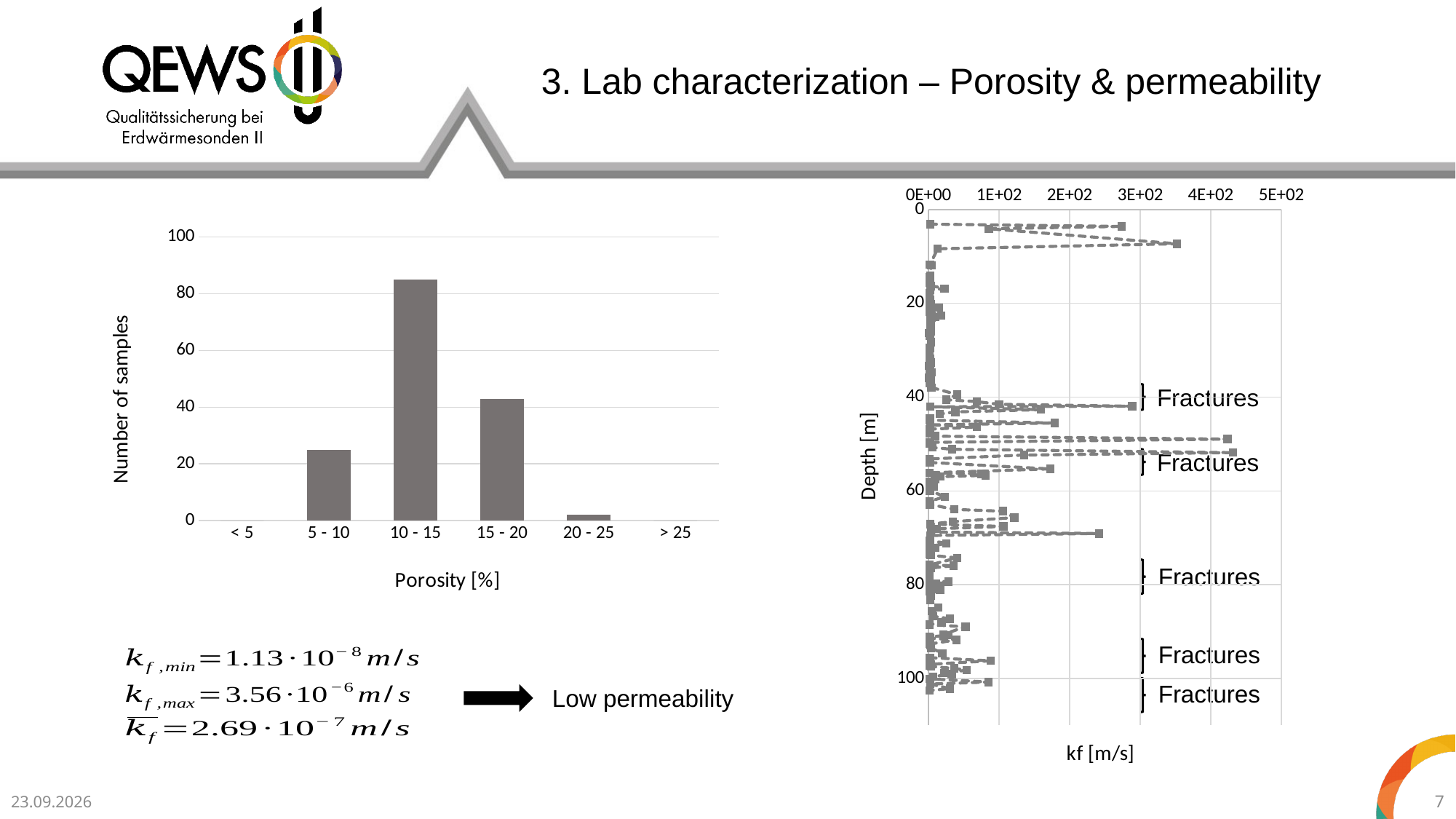
In the left bar chart, what is the label of the y axis? Number of samples In the right chart, what is the highest value shown on the horizontal kf [m/s] axis? 5E+02 In the left bar chart, is the number of samples for the 10 - 15 porosity category greater or less than 80? greater In the left bar chart, which porosity category has the highest number of samples? 10 - 15 In the left bar chart, how many porosity categories are shown on the x axis? 6 In the left bar chart, is the number of samples for the 15 - 20 porosity category greater or less than 60? less In the left bar chart, which has more samples, the 5 - 10 category or the 15 - 20 category? 15 - 20 In the right chart, how many times does the annotation "Fractures" appear? 5 In the right chart, what is the label of the vertical axis? Depth [m] What kind of chart is the left chart showing Number of samples against Porosity [%]? bar chart In the left bar chart, is the number of samples for the 20 - 25 porosity category greater or less than 20? less